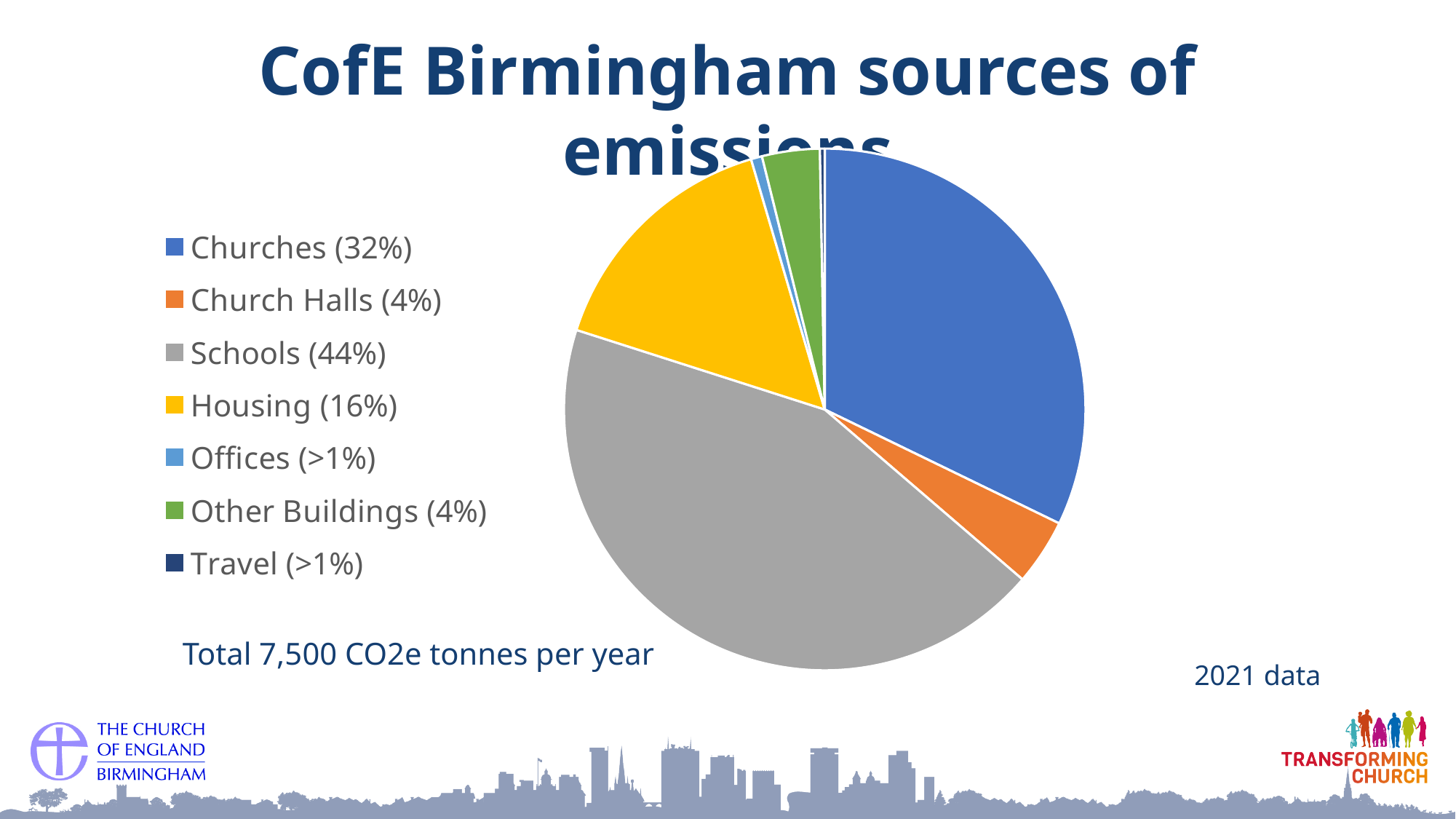
Which colour represents Housing in the pie chart? yellow What year is the data from? 2021 What share of emissions comes from Church Halls? 4% Which is larger, the share for Churches or the share for Housing? Churches What share of emissions comes from Housing? 16% What share of emissions comes from Schools? 44% Which source accounts for the largest share of emissions? Schools What is the difference in percentage points between the Schools share and the Churches share? 12 What type of chart is shown on the slide? pie chart What is the total annual emissions figure stated on the slide? 7,500 CO2e tonnes per year How many emission sources are listed in the legend? 7